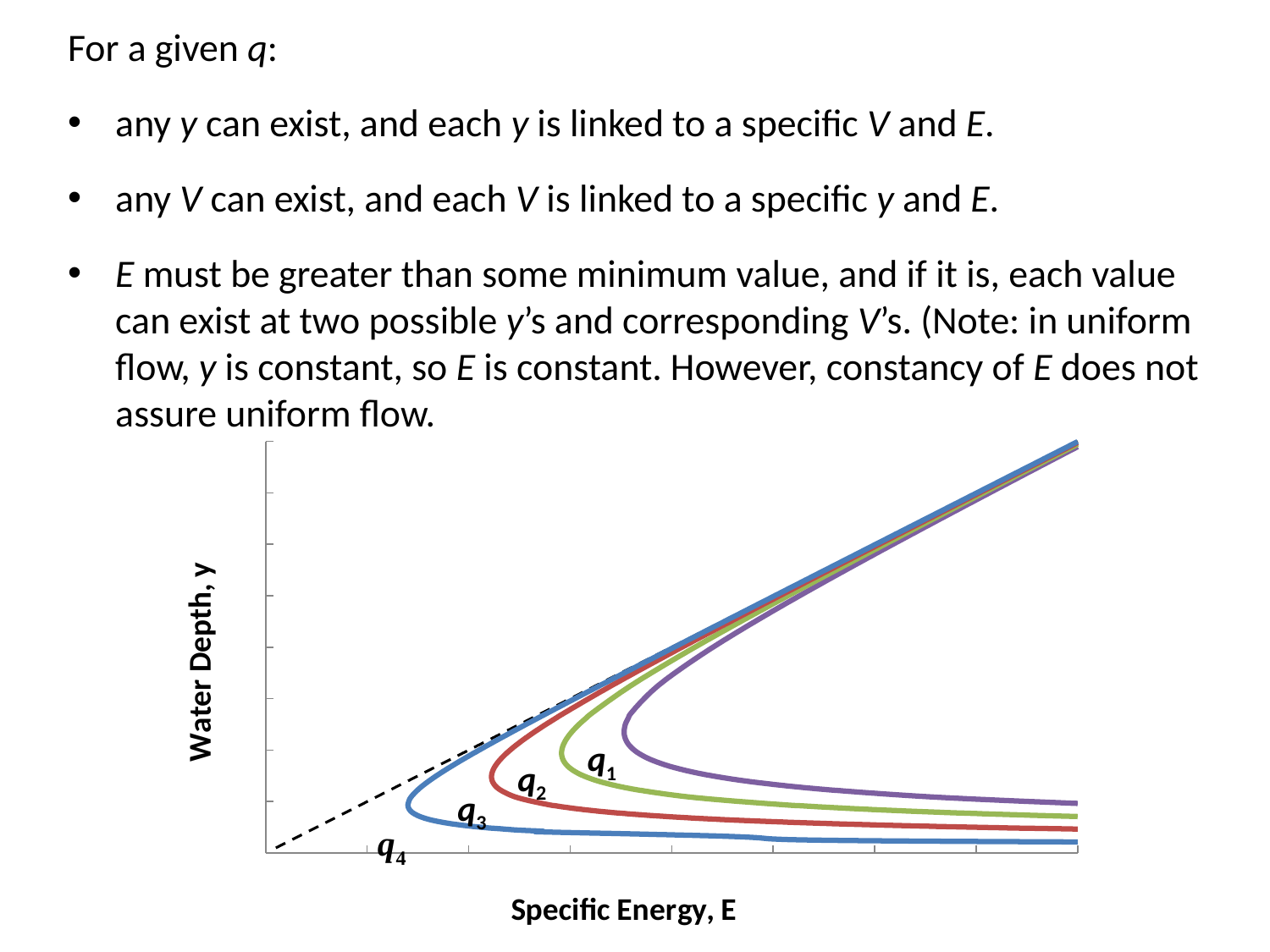
Along the upper branch of the curves, does water depth y rise or fall as specific energy E increases? rise Which curve has the largest minimum specific energy E? q1 Which curve reaches its minimum specific energy at the smallest value of E? q4 What is the label of the y axis of the chart? Water Depth, y Is the minimum specific energy of curve q1 larger or smaller than that of curve q3? larger Along the lower branch of the curves, does water depth y rise or fall as specific energy E increases? fall How many q curves are plotted on the chart? 4 What is the label of the x axis of the chart? Specific Energy, E What kind of chart is shown on the slide? line chart Is the minimum specific energy of curve q4 larger or smaller than that of curve q2? smaller